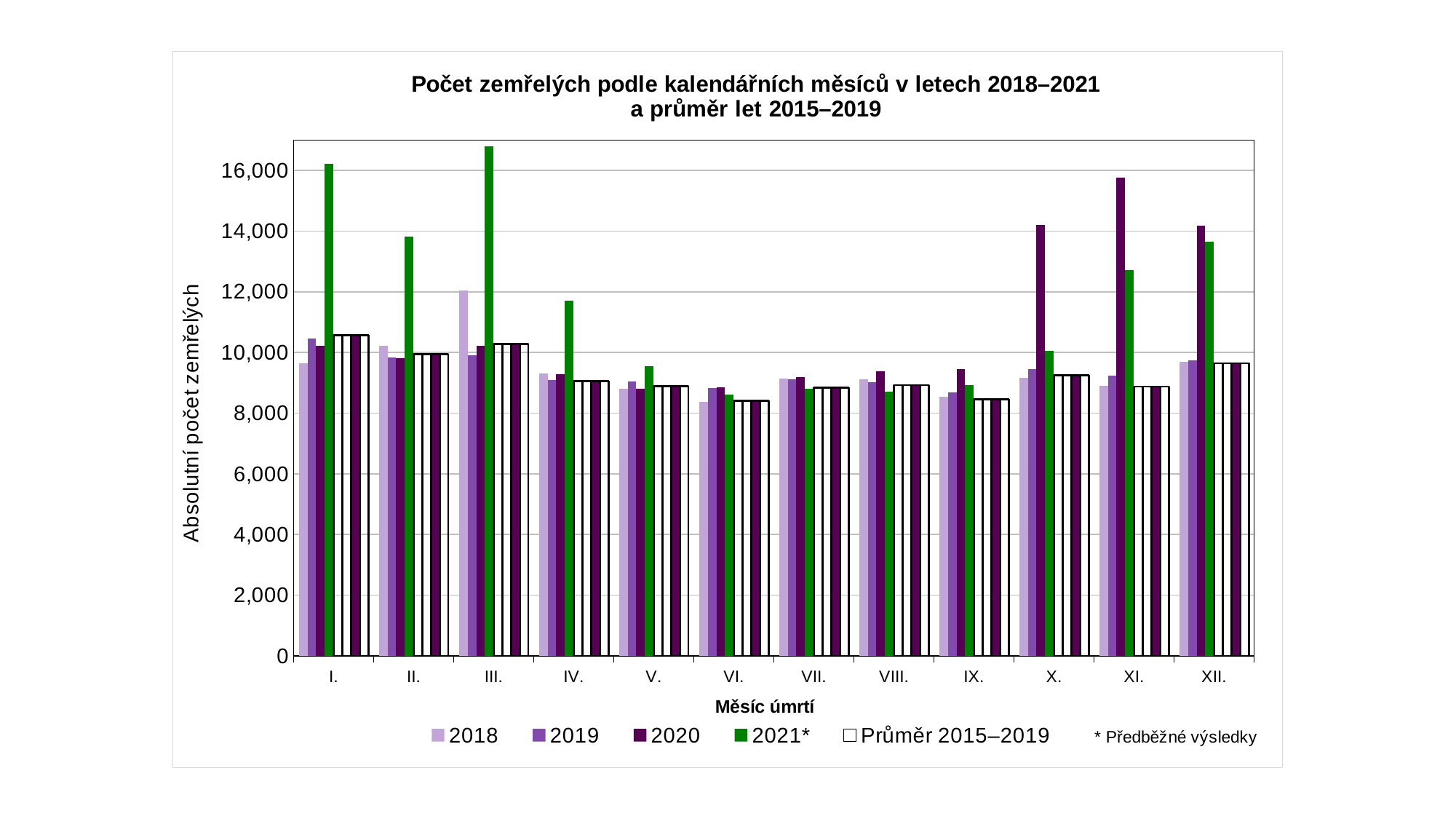
For month X., which is larger: the 2020 value or the 2021* value? 2020 What kind of chart is shown on the slide? bar chart How many months (categories) are shown on the x axis? 12 Is the 2021* value for month III. greater or less than 16,000? greater In which month is the 2020 value the highest? XI. Is the 2021* value for month I. greater or less than 14,000? greater For month I., which is larger: the 2020 value or the 2021* value? 2021* Is the 2018 value for month III. greater or less than 10,000? greater In which month is the 2021* value the highest? III. What is the title of the x axis? Měsíc úmrtí How many series does the legend list? 5